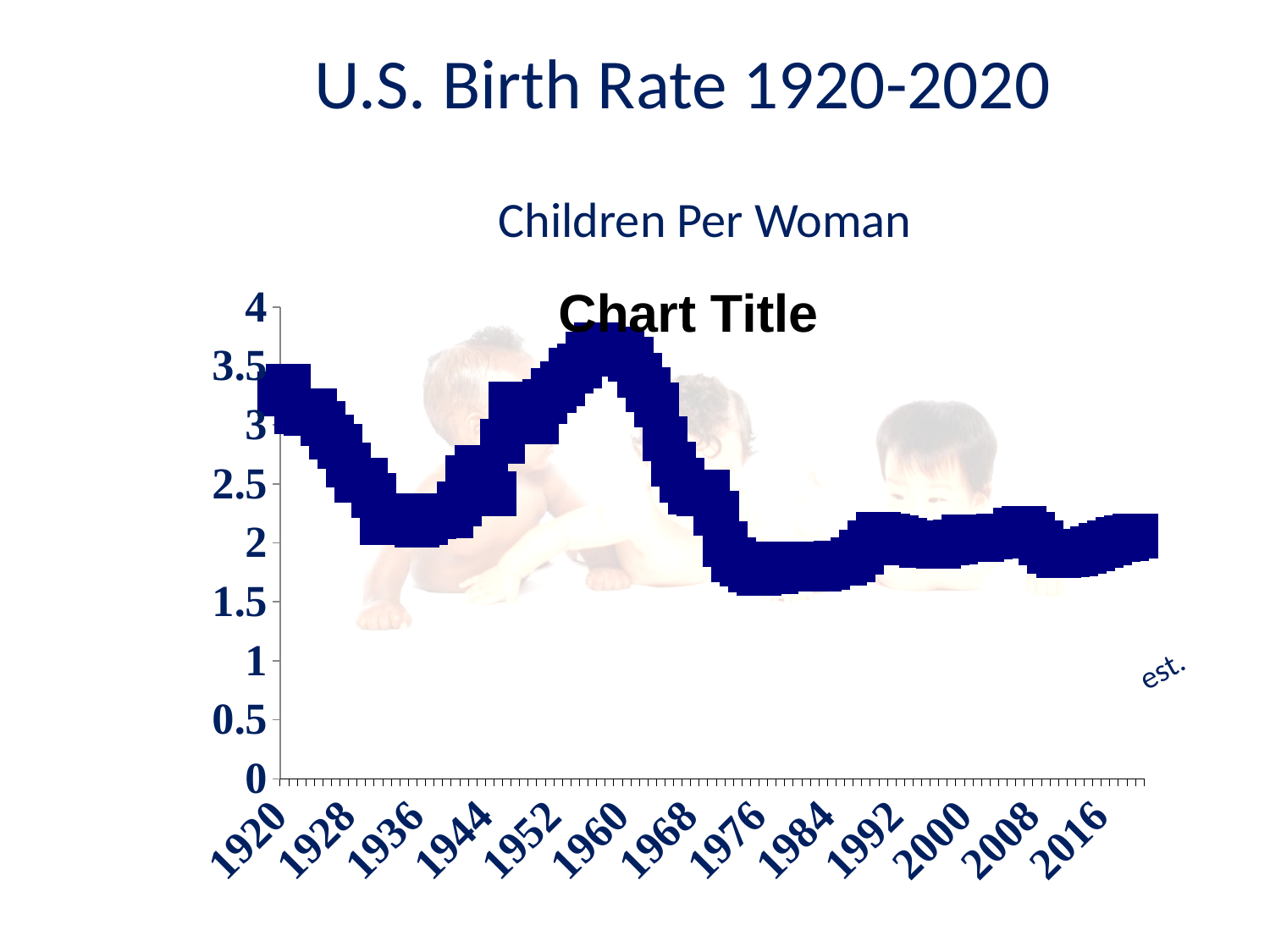
Which has the larger value, 1960 or 1976? 1960 Is the value for 2016 greater or less than 3? less Is the value for 1936 greater or less than 3? less Which has the larger value, 1920 or 2016? 1920 Which of the labeled years on the x axis has the highest value? 1960 What kind of chart is shown on the slide? line chart Is the value for 1920 greater or less than 2.5? greater Do the values rise or fall between 1936 and 1960? rise Do the values rise or fall between 1960 and 1976? fall How many year labels are shown on the x axis? 13